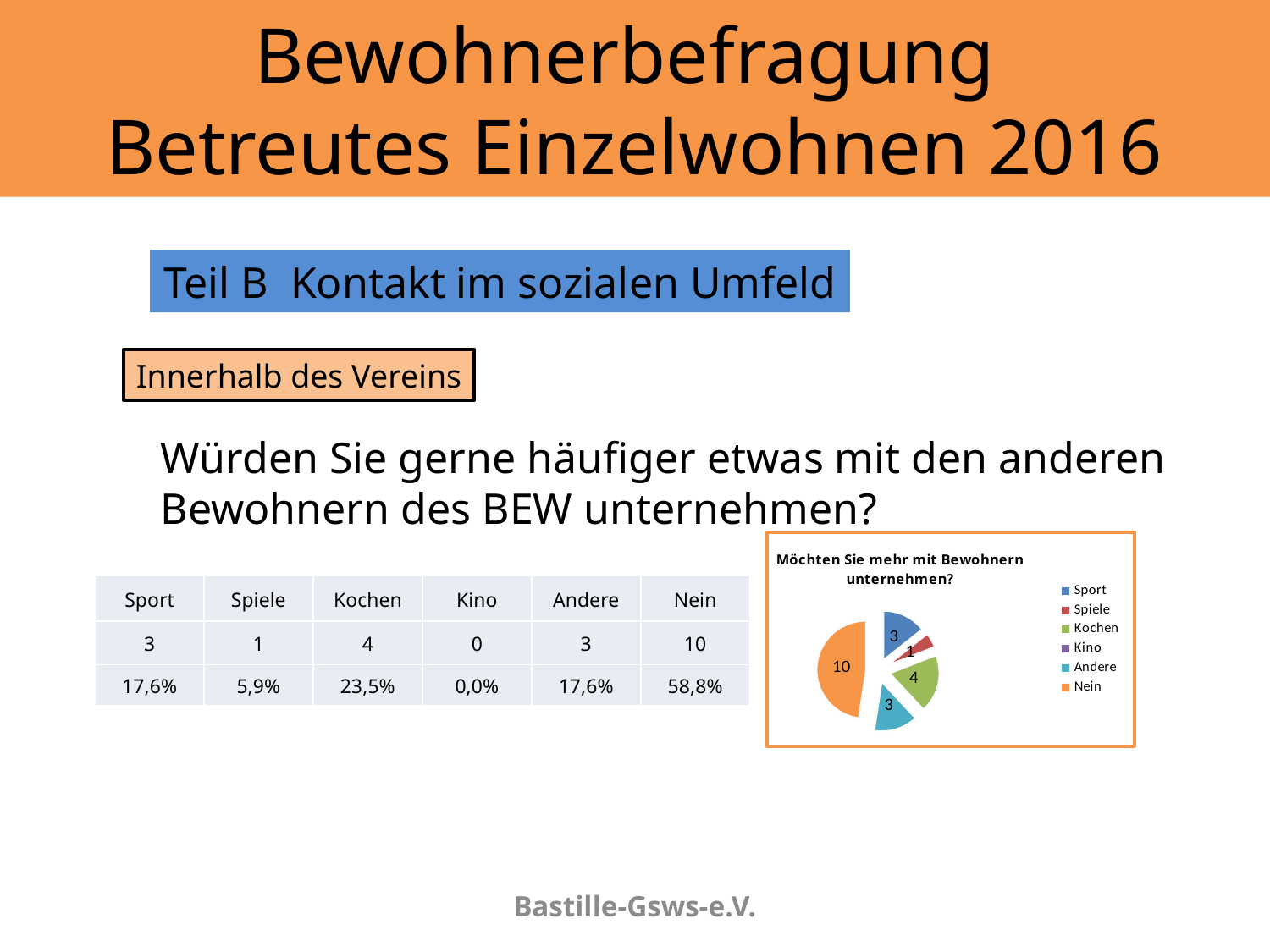
What is the difference between the values for Nein and Kochen in the pie chart? 6 Which of the labelled slices in the pie chart is the smallest? Spiele What is the value for Kochen in the pie chart? 4 What is the title of the pie chart? Möchten Sie mehr mit Bewohnern unternehmen? Which category has the largest slice in the pie chart? Nein What is the value for Spiele in the pie chart? 1 Which legend entry of the pie chart is shown in orange? Nein What is the value for Sport in the pie chart? 3 What kind of chart is shown on the slide? pie chart Which is larger in the pie chart, Kochen or Sport? Kochen How many entries does the legend of the pie chart list? 6 What is the value for Nein in the pie chart? 10